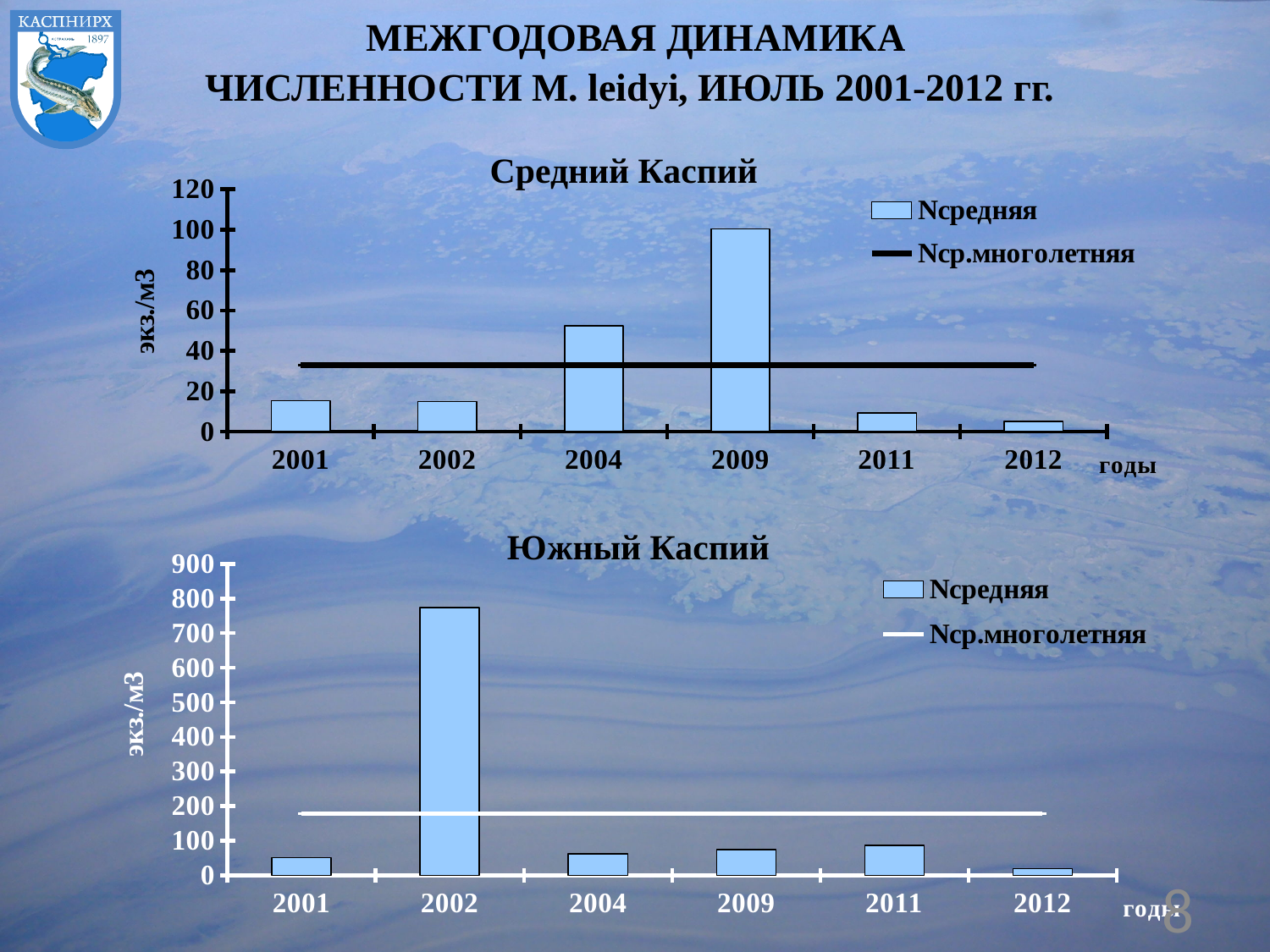
In the 'Южный Каспий' chart, is the value for 2002 greater or less than 700? greater In the 'Южный Каспий' chart, which year has the highest Nсредняя bar? 2002 In the 'Южный Каспий' chart, is the value for 2011 greater or less than 100? less In the 'Южный Каспий' chart, which year has the lowest Nсредняя bar? 2012 In the 'Средний Каспий' chart, which year has the lowest Nсредняя bar? 2012 In the 'Средний Каспий' chart, is the value for 2011 greater or less than 20? less In the 'Южный Каспий' chart, which is larger, the value for 2002 or the value for 2009? 2002 How many series does the legend of the 'Южный Каспий' chart list? 2 In the 'Средний Каспий' chart, which year has the highest Nсредняя bar? 2009 In the 'Средний Каспий' chart, how many years are shown on the x axis? 6 What kind of chart is the 'Средний Каспий' chart? Combination bar and line chart